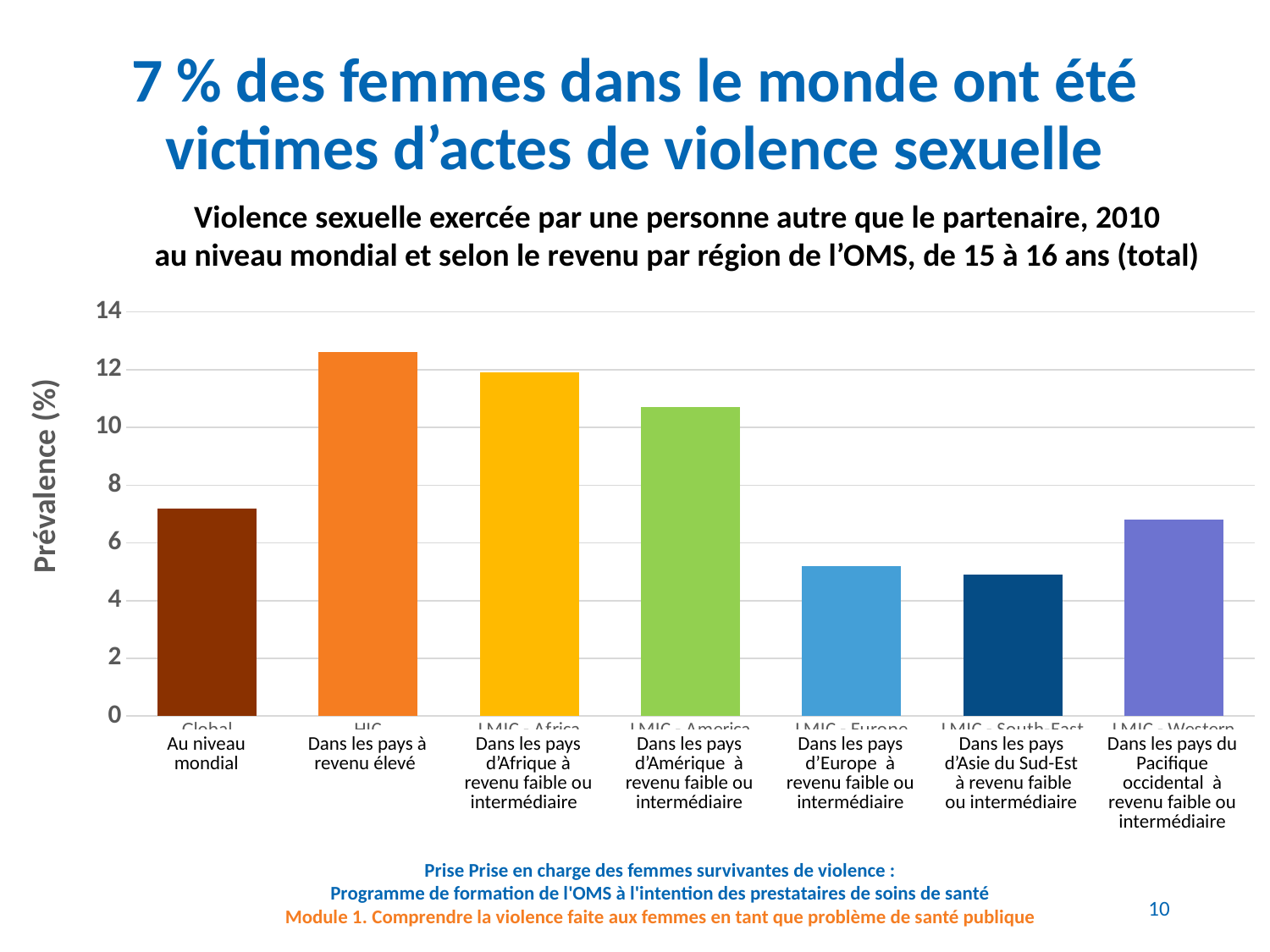
Is the value for "Dans les pays à revenu élevé" greater or less than 12? greater Is the value for "Dans les pays d'Asie du Sud-Est à revenu faible ou intermédiaire" greater or less than 6? less Which is larger: the value for "Dans les pays d'Amérique à revenu faible ou intermédiaire" or the value for "Dans les pays d'Europe à revenu faible ou intermédiaire"? Dans les pays d'Amérique à revenu faible ou intermédiaire What is the maximum value shown on the vertical axis of the chart? 14 What is the label of the vertical axis of the chart? Prévalence (%) Is the value for "Au niveau mondial" greater or less than 6? greater How many categories (bars) are plotted in the chart? 7 Which category has the highest prevalence in the chart? Dans les pays à revenu élevé What kind of chart is shown on the slide? bar chart Which is larger: the value for "Au niveau mondial" or the value for "Dans les pays du Pacifique occidental à revenu faible ou intermédiaire"? Au niveau mondial